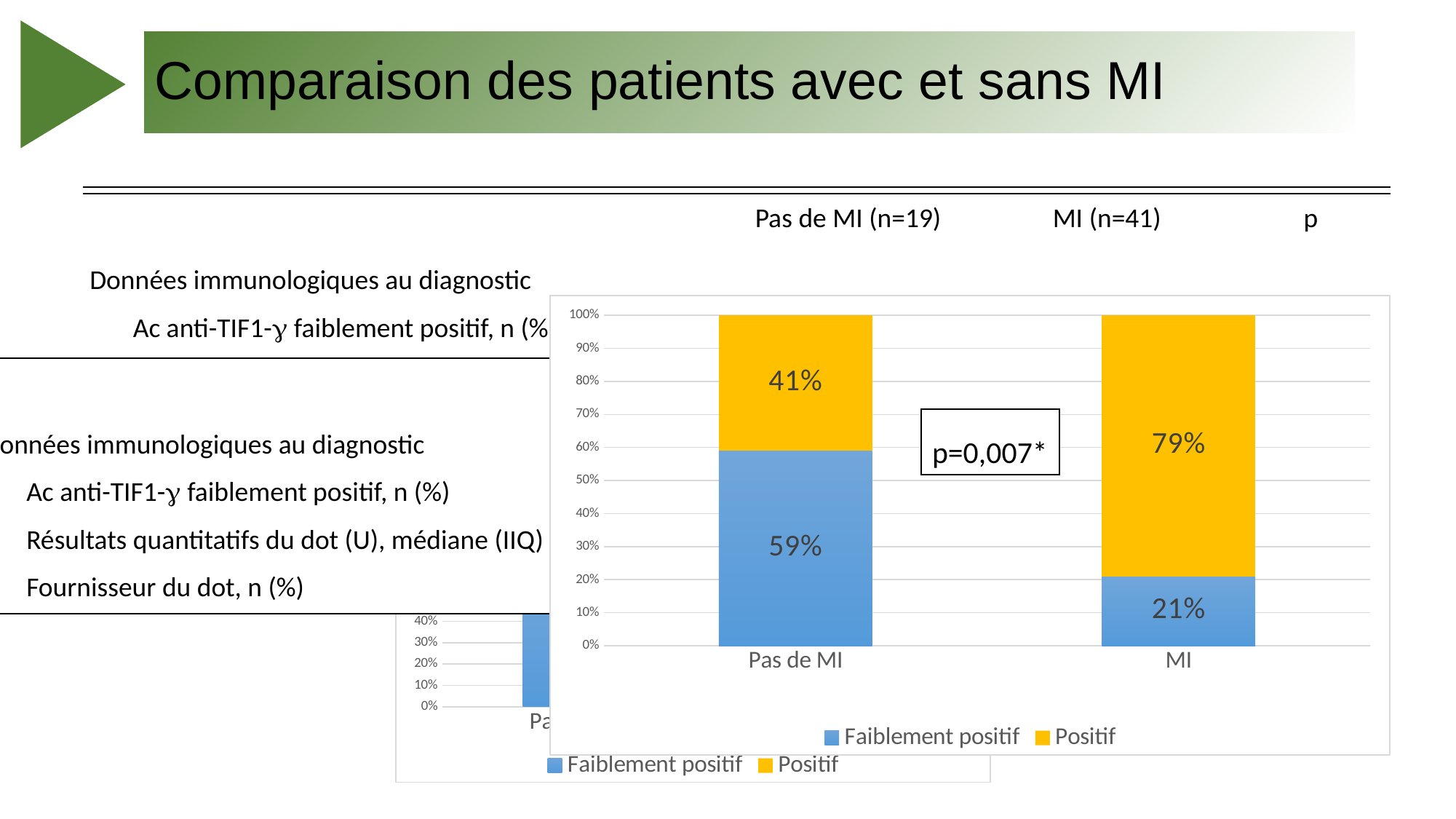
In the front stacked bar chart, what is the difference between the Positif values for MI and Pas de MI? 38% In the front stacked bar chart, which category has the lowest Faiblement positif value? MI In the front stacked bar chart, what is the value for Faiblement positif in the Pas de MI bar? 59% What p-value is printed inside the front stacked bar chart? p=0,007* In the front stacked bar chart, what is the total of the Pas de MI bar? 100% How many categories are shown on the x axis of the front stacked bar chart? 2 In the front stacked bar chart, which category has the higher Positif share, Pas de MI or MI? MI In the front stacked bar chart, what is the value for Positif in the Pas de MI bar? 41% What kind of chart is the front chart on the slide? Stacked bar chart How many series does the legend of the front stacked bar chart list? 2 In the front stacked bar chart, what is the value for Faiblement positif in the MI bar? 21% In the front stacked bar chart, what is the value for Positif in the MI bar? 79%